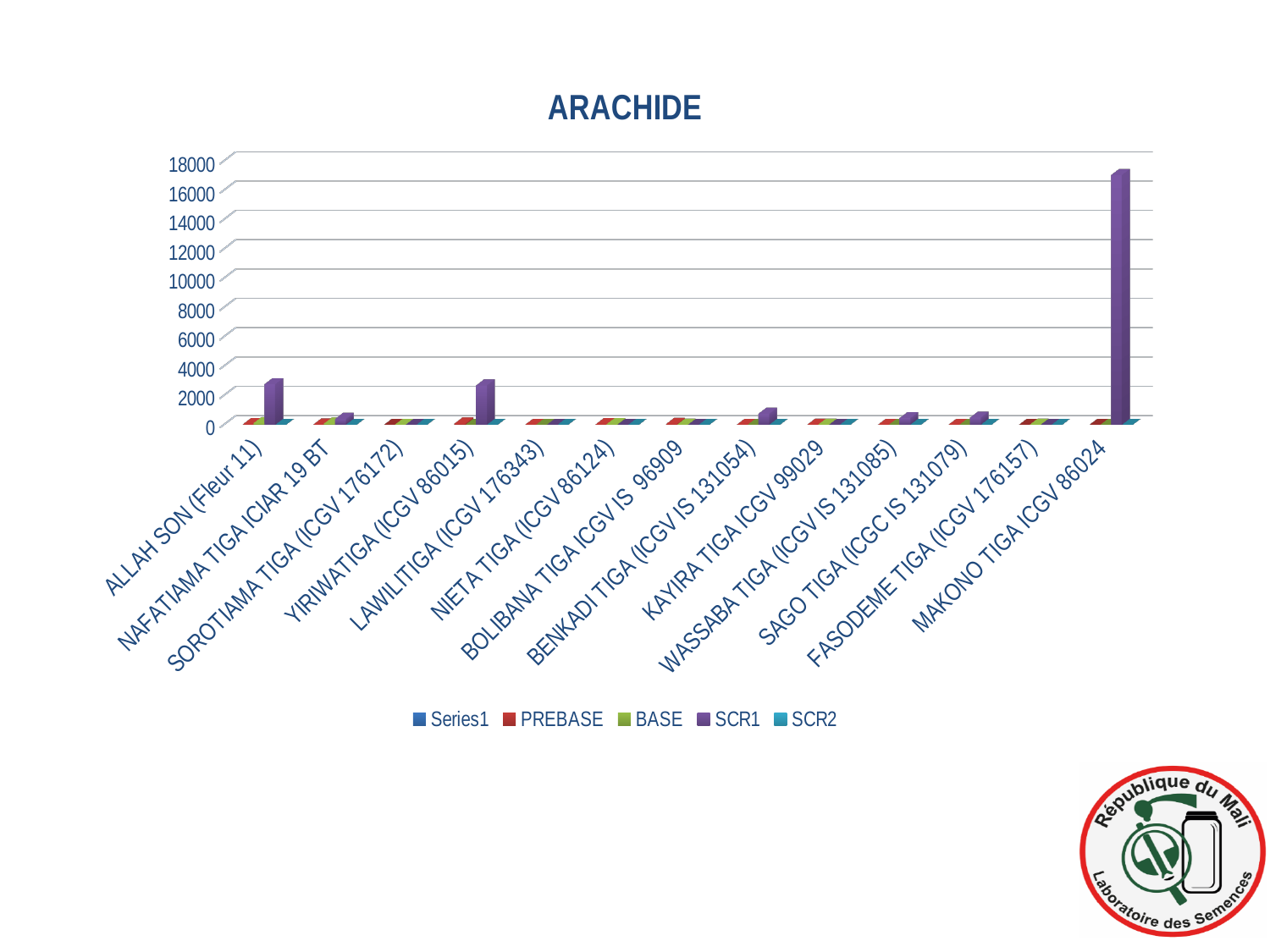
How many series does the legend list? 5 What kind of chart is shown on the slide? bar chart How many categories are shown on the x axis? 13 Is the SCR1 value for ALLAH SON (Fleur 11) greater or less than 4000? less What is the title of the chart? ARACHIDE Which has the larger SCR1 value, ALLAH SON (Fleur 11) or NAFATIAMA TIGA ICIAR 19 BT? ALLAH SON (Fleur 11) Which has the larger SCR1 value, MAKONO TIGA ICGV 86024 or ALLAH SON (Fleur 11)? MAKONO TIGA ICGV 86024 Is the SCR1 value for BENKADI TIGA (ICGV IS 131054) greater or less than 2000? less Which category has the highest SCR1 value? MAKONO TIGA ICGV 86024 Is the SCR1 value for MAKONO TIGA ICGV 86024 greater or less than 16000? greater What is the maximum value shown on the vertical axis? 18000